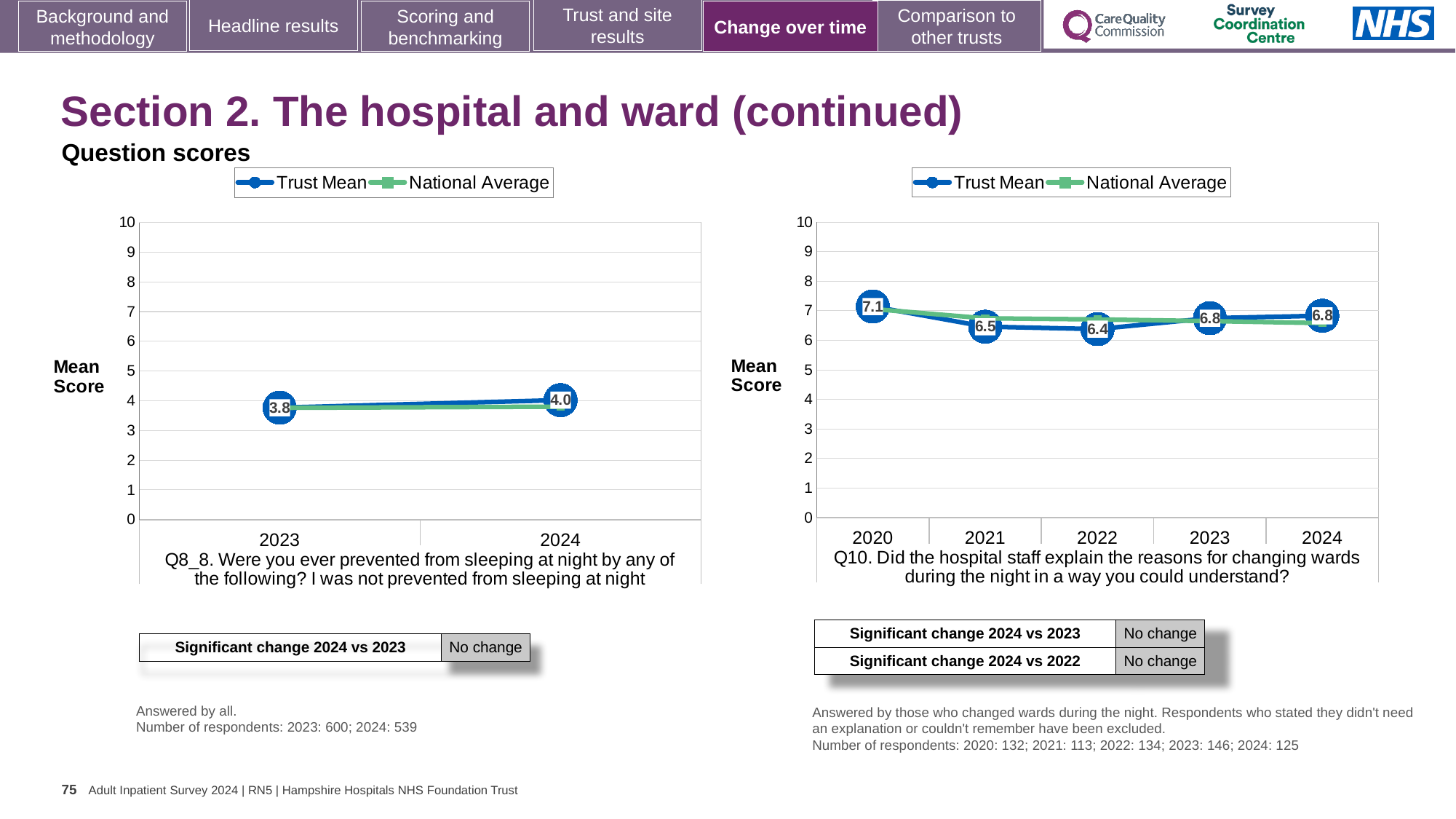
On the left chart (Q8_8), what is the Trust Mean score for 2024? 4.0 On the right chart (Q10), how many years are shown on the x axis? 5 On the right chart (Q10), what is the Trust Mean score for 2022? 6.4 What type of chart is used on the right (Q10)? Line chart On the right chart (Q10), which year has the lowest Trust Mean score? 2022 On the left chart (Q8_8), how many series does the legend list? 2 On the left chart (Q8_8), does the Trust Mean rise or fall from 2023 to 2024? Rise On the right chart (Q10), what is the difference between the Trust Mean scores for 2020 and 2022? 0.7 On the left chart (Q8_8), what is the Trust Mean score for 2023? 3.8 On the right chart (Q10), which year has the highest Trust Mean score? 2020 On the left chart (Q8_8), is the Trust Mean score for 2024 greater or less than 5? less On the right chart (Q10), what is the Trust Mean score for 2020? 7.1